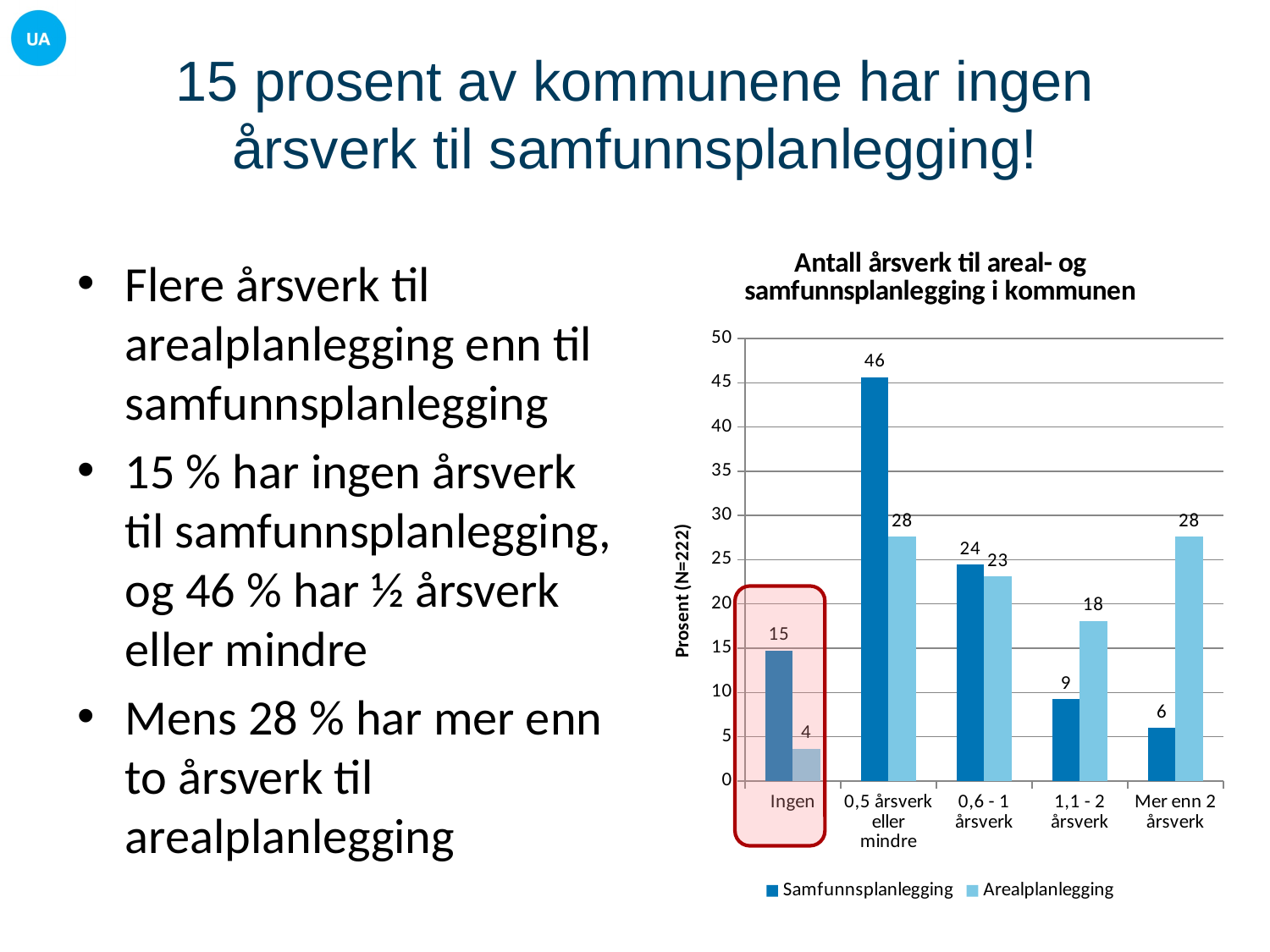
Which category has the lowest value for Arealplanlegging? Ingen What is the label of the y axis? Prosent (N=222) What is the difference between Samfunnsplanlegging and Arealplanlegging in the '0,5 årsverk eller mindre' category? 18 What is the value for Arealplanlegging in the 'Mer enn 2 årsverk' category? 28 What kind of chart is shown on the slide? Bar chart What is the value for Samfunnsplanlegging in the 'Ingen' category? 15 How many categories are shown on the x axis? 5 What is the value for Samfunnsplanlegging in the '0,5 årsverk eller mindre' category? 46 Which category has the highest value for Samfunnsplanlegging? 0,5 årsverk eller mindre What is the title of the chart? Antall årsverk til areal- og samfunnsplanlegging i kommunen In the 'Mer enn 2 årsverk' category, which series has the larger value, Samfunnsplanlegging or Arealplanlegging? Arealplanlegging How many series does the legend list? 2